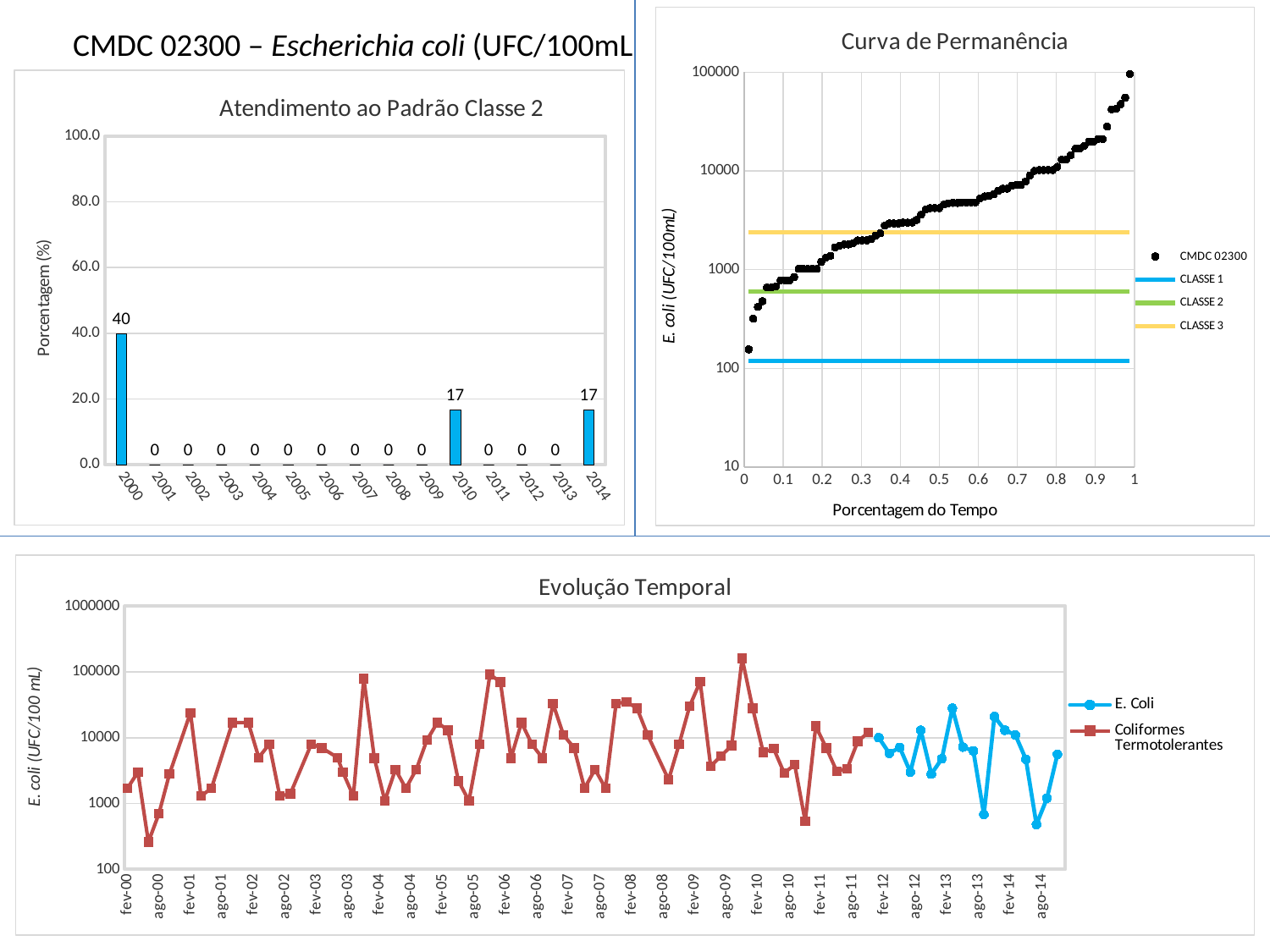
How many years are shown on the x axis of the 'Atendimento ao Padrão Classe 2' chart? 15 How many series does the legend of the 'Evolução Temporal' chart list? 2 What kind of chart is 'Evolução Temporal'? line chart In the 'Atendimento ao Padrão Classe 2' chart, what is the value for 2005? 0 In the 'Atendimento ao Padrão Classe 2' chart, what is the value for 2010? 17 In the 'Atendimento ao Padrão Classe 2' chart, which year has the highest value? 2000 In the 'Curva de Permanência' chart, is the CLASSE 1 line greater or less than 1000? less How many entries does the legend of the 'Curva de Permanência' chart list? 4 In the 'Atendimento ao Padrão Classe 2' chart, what is the difference between the values for 2000 and 2014? 23 What kind of chart is 'Atendimento ao Padrão Classe 2'? bar chart In the 'Atendimento ao Padrão Classe 2' chart, which is larger, the value for 2000 or the value for 2010? 2000 In the 'Atendimento ao Padrão Classe 2' chart, what is the value for 2000? 40